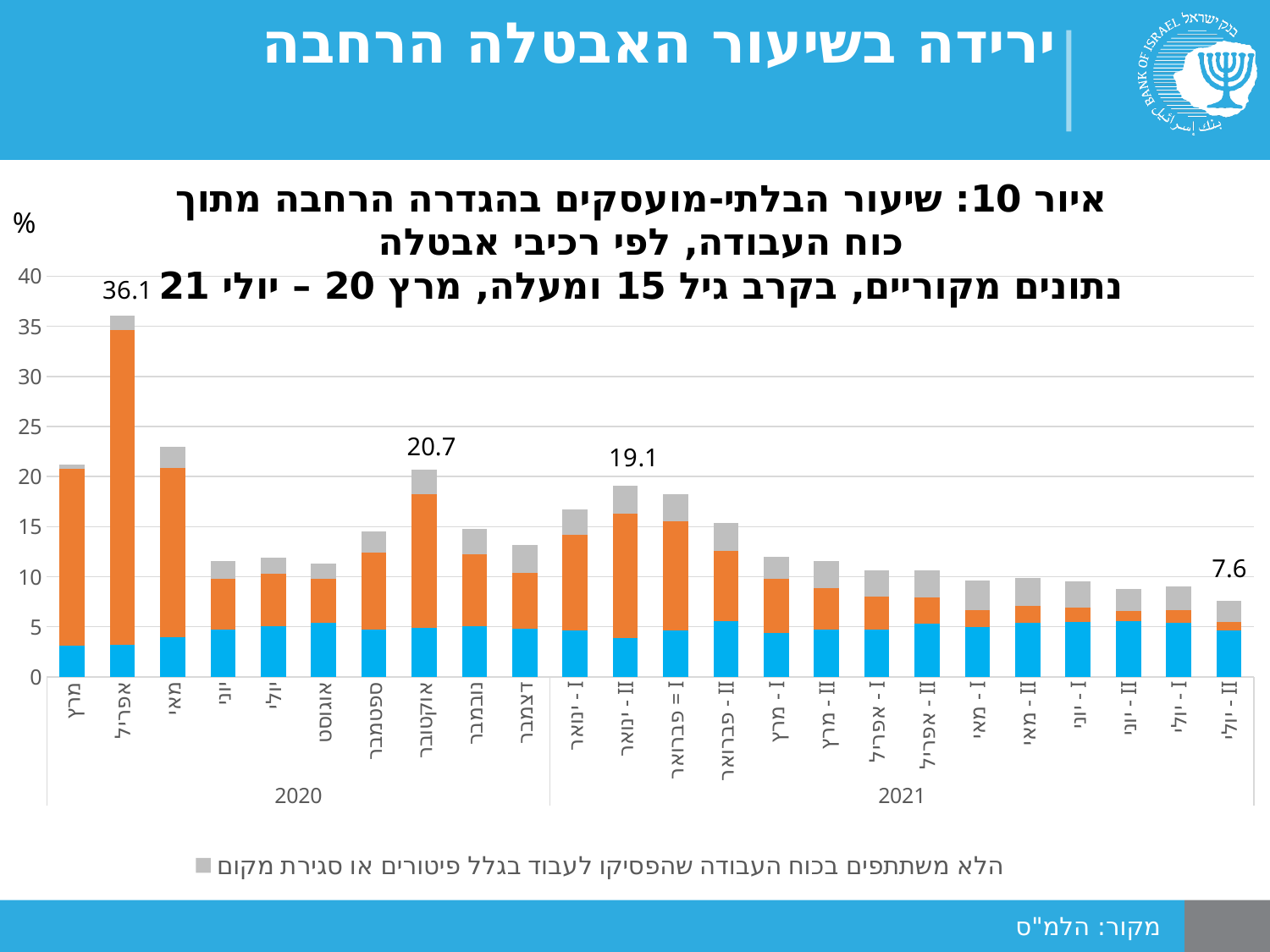
Which is larger: the total for October 2020 or the total for the second half of January 2021? October 2020 What is the total value labelled for April 2020 (אפריל)? 36.1 What is the difference between the labelled values for April 2020 (36.1) and the second half of July 2021 (7.6)? 28.5 Which month has the highest total unemployment rate in the chart? April 2020 (אפריל) What is the total value labelled for the second half of January 2021 (ינואר - II)? 19.1 How many bars (periods) are plotted in the chart? 24 What is the difference between the labelled values for October 2020 (20.7) and the second half of January 2021 (19.1)? 1.6 Is the total value for May 2020 (מאי) greater or less than 20? greater What is the total value labelled for the second half of July 2021 (יולי - II)? 7.6 What kind of chart is shown on the slide? Stacked bar chart What is the total value labelled for October 2020 (אוקטובר)? 20.7 Do the total values rise or fall from the second half of January 2021 to the second half of July 2021? fall